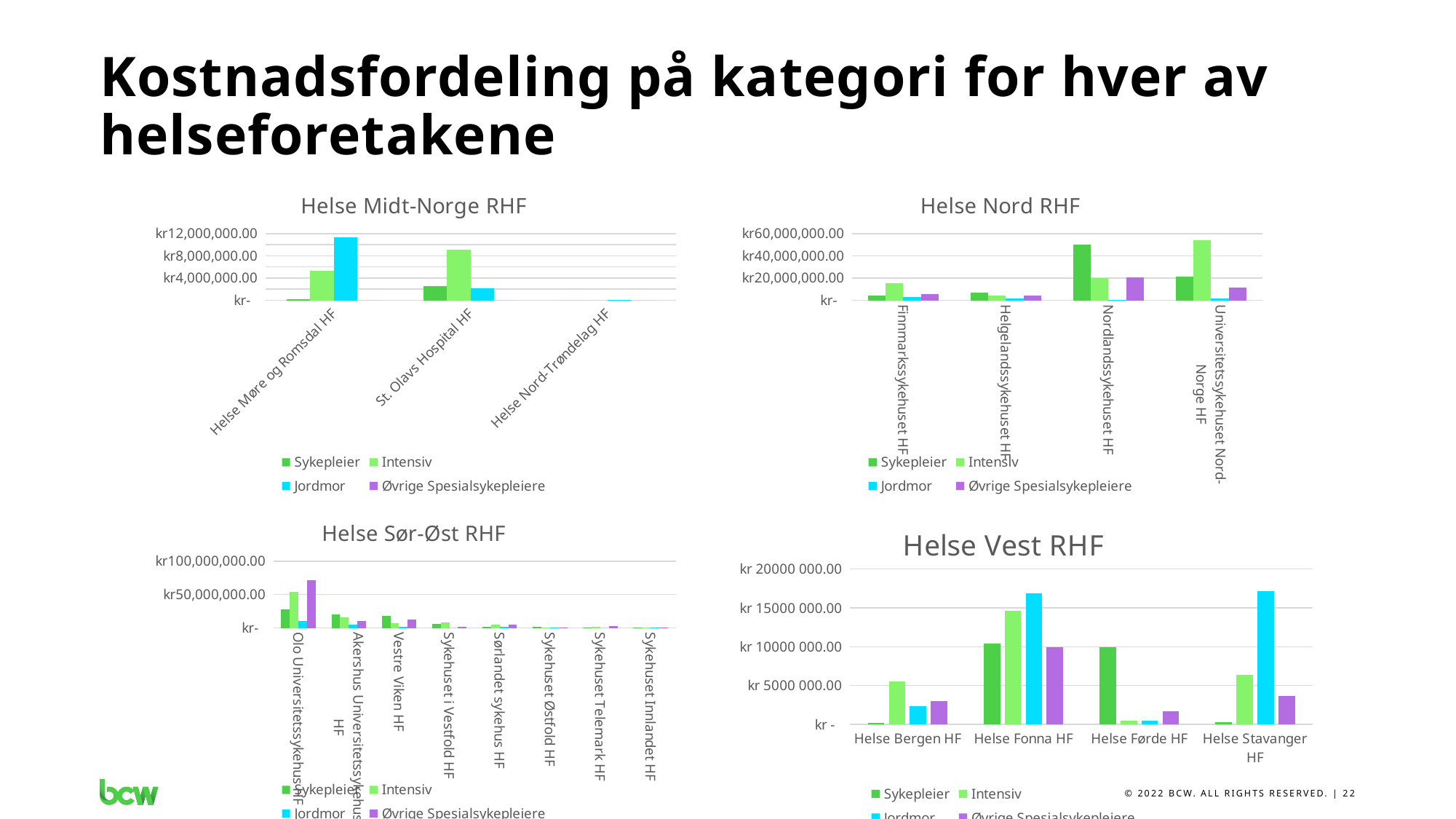
In the Helse Midt-Norge RHF chart, how many categories are shown on the x axis? 3 In the Helse Midt-Norge RHF chart, is the Jordmor value for Helse Møre og Romsdal HF greater or less than kr8,000,000.00? greater In the Helse Sør-Øst RHF chart, which series has the tallest bar for Oslo Universitetssykehus HF? Øvrige Spesialsykepleiere In the Helse Vest RHF chart, which is larger for Helse Bergen HF: Sykepleier or Intensiv? Intensiv How many series does the legend of the Helse Nord RHF chart list? 4 In the Helse Midt-Norge RHF chart, is the Sykepleier value for St. Olavs Hospital HF greater or less than kr4,000,000.00? less In the Helse Vest RHF chart, is the Jordmor value for Helse Stavanger HF greater or less than kr 15000 000.00? greater In the Helse Sør-Øst RHF chart, how many health trusts (categories) are shown on the x axis? 8 In the Helse Vest RHF chart, which series has the lowest value for Helse Bergen HF? Sykepleier What kind of chart is the Helse Vest RHF chart? bar chart